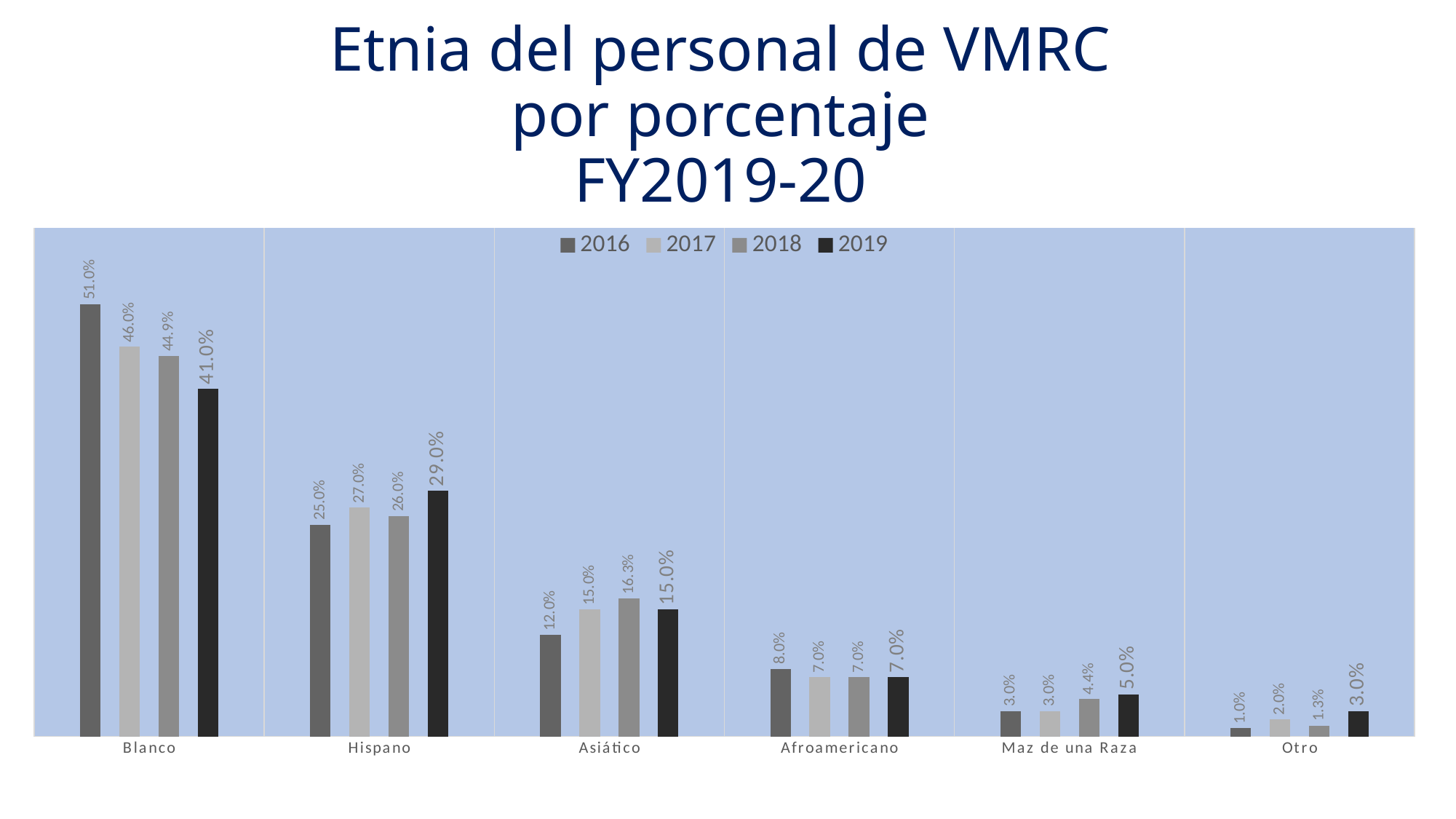
What kind of chart is shown on the slide? Bar chart What was the value for Asiático in 2018? 16.3% Which category had the highest value in 2016? Blanco How many ethnicity categories are shown on the x axis? 6 What was the value for Maz de una Raza in 2018? 4.4% Did the Blanco share rise or fall from 2016 to 2019? Fall Which category had the lowest value in 2019? Otro Which is larger: the Hispano value in 2019 or the Hispano value in 2016? 2019 What percentage of VMRC staff was Blanco in 2019? 41.0% How many series does the legend list? 4 By how many percentage points did the Blanco share fall from 2016 to 2019? 10.0% What was the value for Hispano in 2017? 27.0%